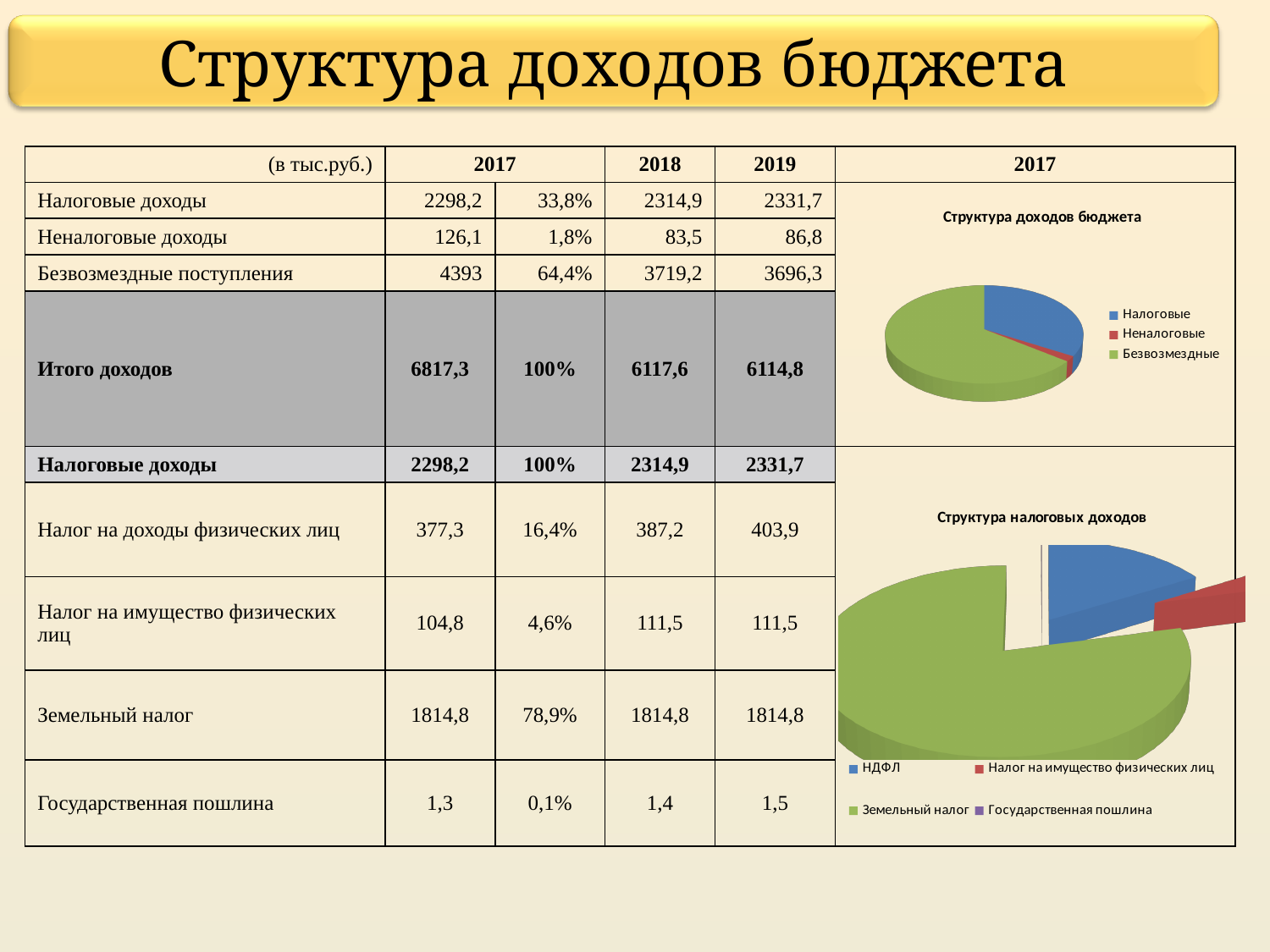
In the top chart "Структура доходов бюджета", which category has the smallest slice? Неналоговые In the top chart "Структура доходов бюджета", which slice is larger: Налоговые or Неналоговые? Налоговые In the bottom chart "Структура налоговых доходов", which category has the smallest slice? Государственная пошлина What kind of chart is the top chart titled "Структура доходов бюджета"? pie chart In the bottom chart "Структура налоговых доходов", which slice is larger: НДФЛ or Налог на имущество физических лиц? НДФЛ In the bottom chart "Структура налоговых доходов", what colour is the slice for Земельный налог? green In the bottom chart "Структура налоговых доходов", which category has the largest slice? Земельный налог What kind of chart is the bottom chart titled "Структура налоговых доходов"? pie chart In the top chart "Структура доходов бюджета", which category has the largest slice? Безвозмездные What is the title of the top chart on the slide? Структура доходов бюджета In the top chart "Структура доходов бюджета", how many categories does the legend list? 3 In the bottom chart "Структура налоговых доходов", how many categories does the legend list? 4